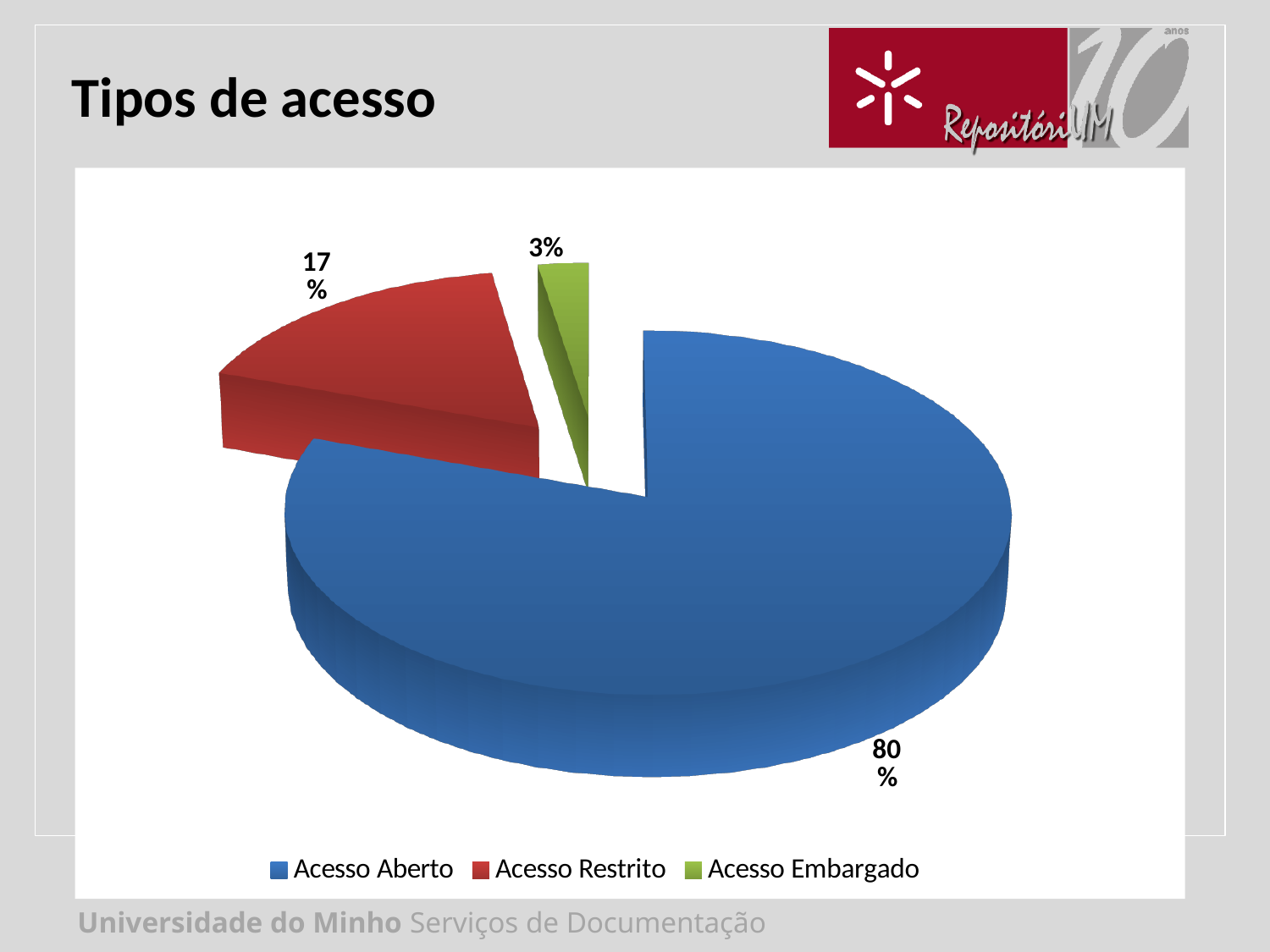
What share of the pie does Acesso Aberto have? 80% What is the title of the slide containing the chart? Tipos de acesso What colour is the Acesso Restrito slice? Red Which is larger, Acesso Restrito or Acesso Embargado? Acesso Restrito What share of the pie does Acesso Embargado have? 3% What is the difference in percentage points between Acesso Aberto and Acesso Restrito? 63 What is the difference in percentage points between Acesso Restrito and Acesso Embargado? 14 How many categories are shown in the pie chart? 3 What share of the pie does Acesso Restrito have? 17% Which category has the smallest slice of the pie? Acesso Embargado Which category has the largest slice of the pie? Acesso Aberto What kind of chart is shown on the slide? Pie chart